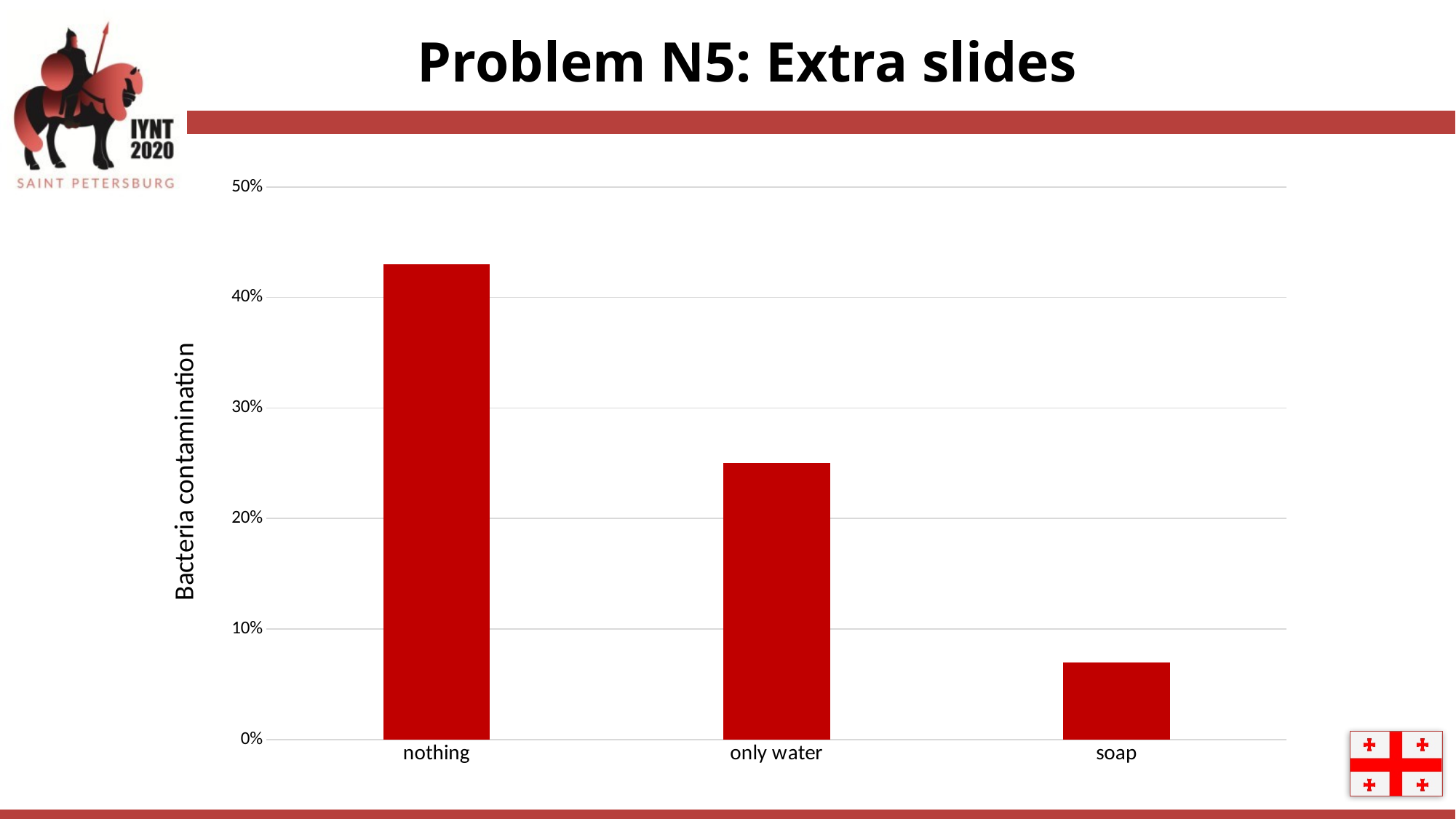
Which has a higher bacteria contamination, only water or soap? only water Which category has the highest bacteria contamination? nothing What is the label on the vertical axis of the chart? Bacteria contamination Is the value for only water greater or less than 30%? less Which has a higher bacteria contamination, nothing or only water? nothing How many categories are shown on the x axis of the chart? 3 Is the value for nothing greater or less than 40%? greater Is the value for soap greater or less than 10%? less Do the bar values rise or fall from left to right along the x axis? fall Which category has the lowest bacteria contamination? soap What kind of chart is shown on the slide? bar chart